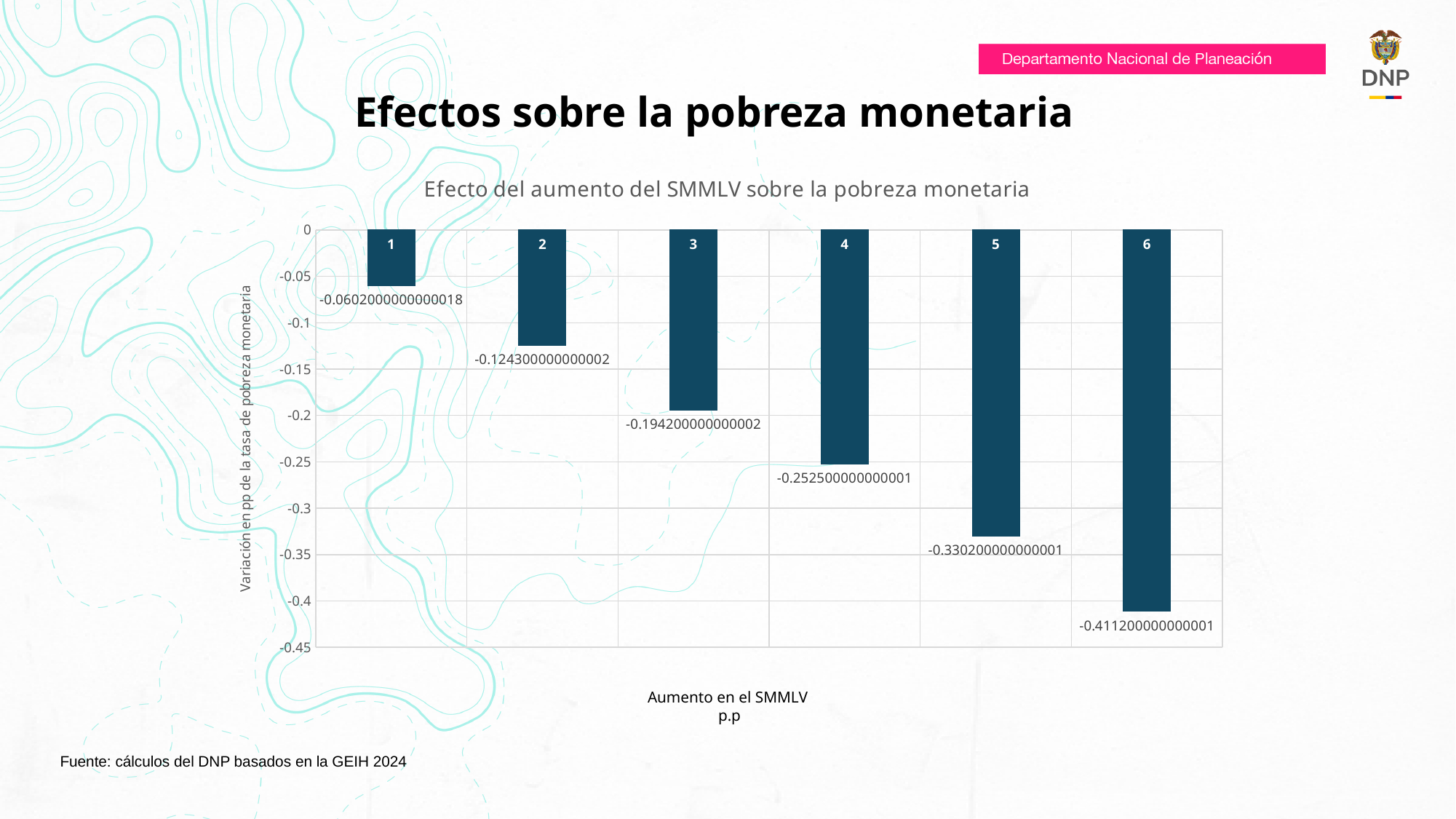
What is the value shown for category 3? -0.194200000000002 What is the label of the vertical axis? Variación en pp de la tasa de pobreza monetaria What type of chart is shown on the slide? Bar chart Do the values rise or fall as the category number increases along the x axis? fall Which category has the highest (least negative) value? 1 How many bars (categories) are plotted in the chart? 6 What is the value shown for category 4? -0.252500000000001 Is the value for category 3 greater or less than -0.2? greater Which category has the lowest (most negative) value? 6 What is the value shown for category 6? -0.411200000000001 What is the title of the chart? Efecto del aumento del SMMLV sobre la pobreza monetaria What is the value shown for category 1? -0.0602000000000018